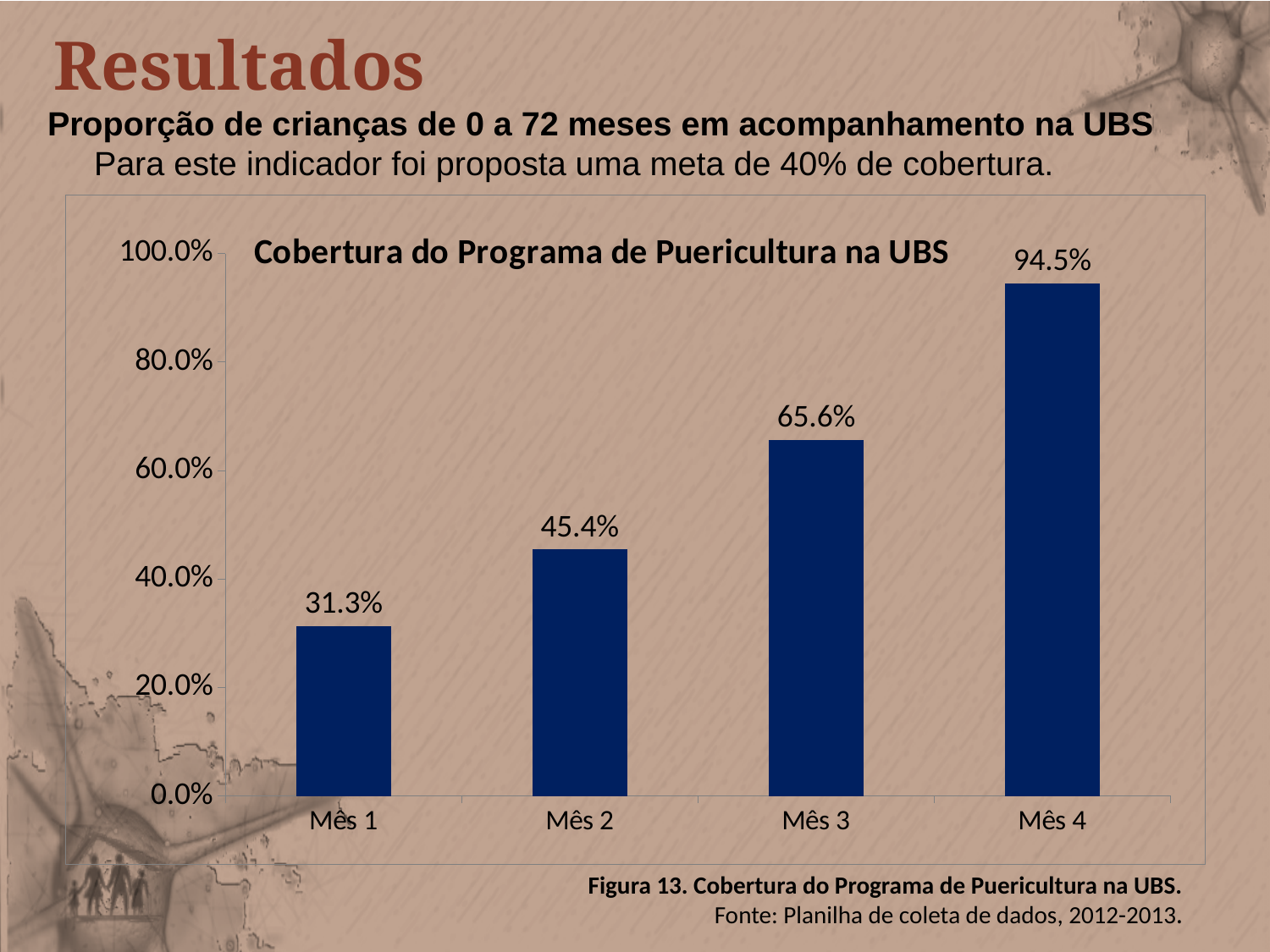
What is the value for Mês 3? 65.6% Which month has the lowest coverage? Mês 1 What is the value for Mês 4? 94.5% How many months are shown on the x axis? 4 What kind of chart is shown? bar chart Which is larger, the value for Mês 2 or the value for Mês 3? Mês 3 Which month has the highest coverage? Mês 4 Is the value for Mês 2 greater or less than 40.0%? greater What is the difference between the values for Mês 2 and Mês 1? 14.1% Do the values rise or fall from Mês 1 to Mês 4? rise What is the difference between the values for Mês 4 and Mês 3? 28.9% What is the value for Mês 1? 31.3%